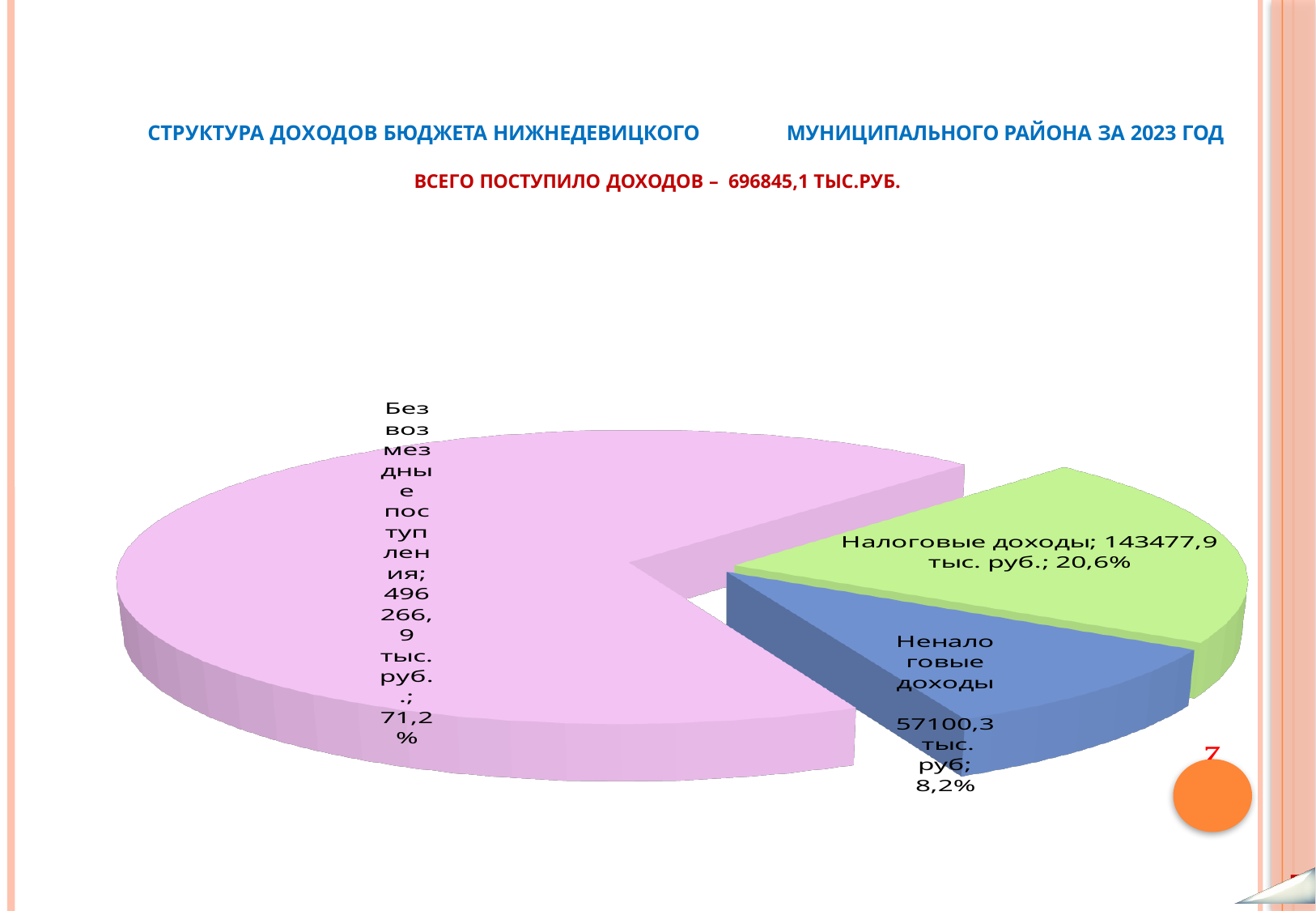
What is the difference in percentage share between Налоговые доходы and Неналоговые доходы? 12,4% What share of the pie does Неналоговые доходы take? 8,2% Which is larger, Налоговые доходы or Неналоговые доходы? Налоговые доходы Which slice of the pie is the largest? Безвозмездные поступления What share of the pie does Безвозмездные поступления take? 71,2% What is the value shown for Безвозмездные поступления? 496266,9 тыс. руб. How many slices does the pie chart have? 3 What is the value shown for Налоговые доходы? 143477,9 тыс. руб. What kind of chart is shown on the slide? pie chart Which slice of the pie is the smallest? Неналоговые доходы What is the value shown for Неналоговые доходы? 57100,3 тыс. руб What share of the pie does Налоговые доходы take? 20,6%